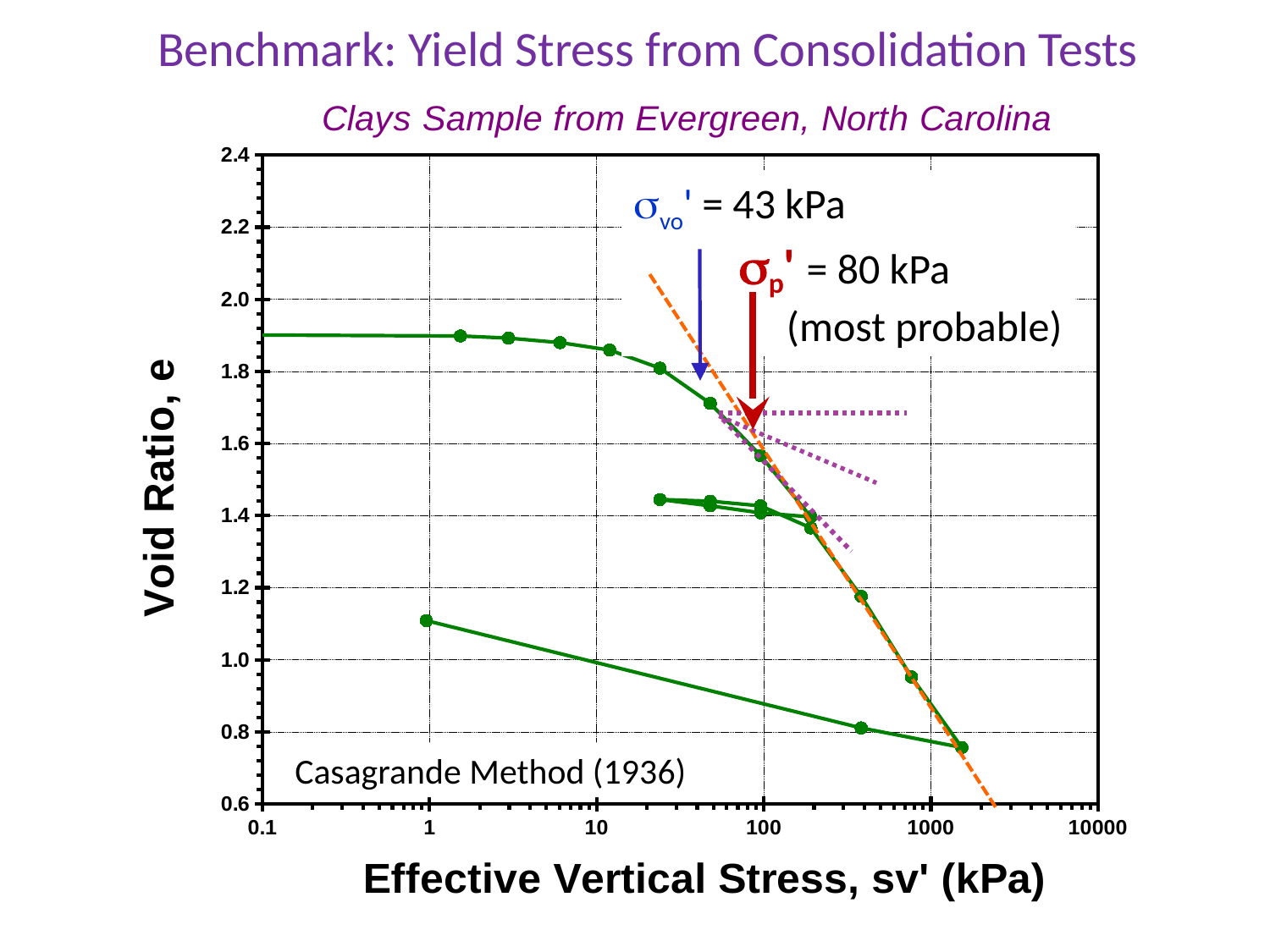
What is the most probable value of σp' annotated on the chart? 80 kPa What is the value of σvo' annotated on the chart? 43 kPa What is the highest tick value shown on the x axis? 10000 What method is named in the lower-left corner of the chart? Casagrande Method (1936) Is the void ratio at the lowest stress on the main curve greater or less than 1.8? greater What kind of chart is shown on the slide? Line chart What is the label of the y axis? Void Ratio, e Does the void ratio rise or fall as effective vertical stress increases along the x axis? Fall Which of the two annotated stresses is larger, σvo' or σp'? σp' What is the lowest tick value shown on the y axis? 0.6 Is the lowest void ratio reached on the curve greater or less than 0.8? less What is the difference between the annotated σp' and σvo' values? 37 kPa